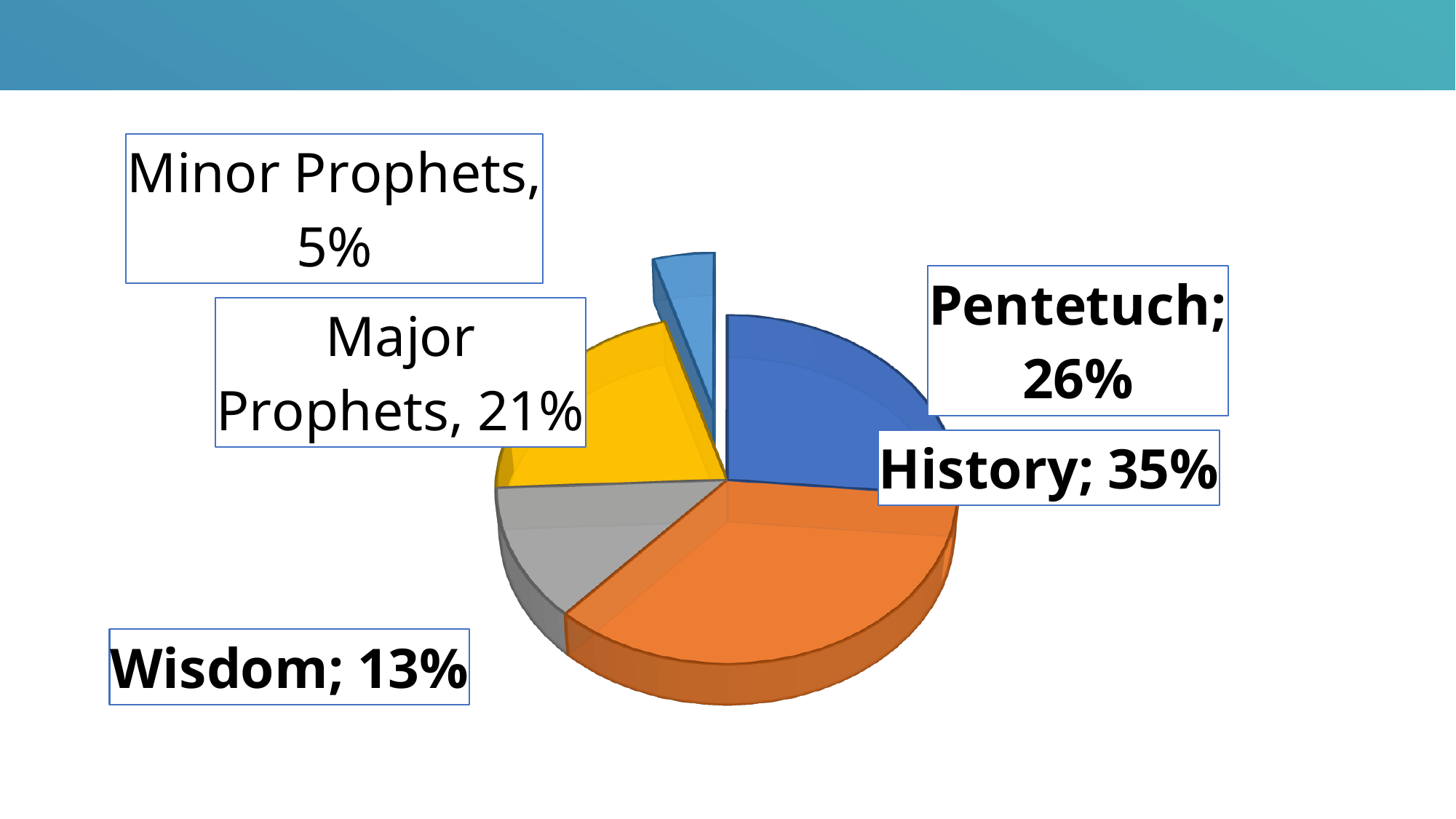
What share of the pie does History have? 35% What is the difference in percentage points between History and Pentetuch? 9 Which category has the smallest slice of the pie? Minor Prophets What share of the pie do the Minor Prophets have? 5% Which is larger, the share for Major Prophets or the share for Wisdom? Major Prophets What kind of chart is shown on the slide? pie chart Which category has the largest slice of the pie? History How many slices does the pie chart have? 5 What colour is the History slice? orange What share of the pie does Wisdom have? 13%